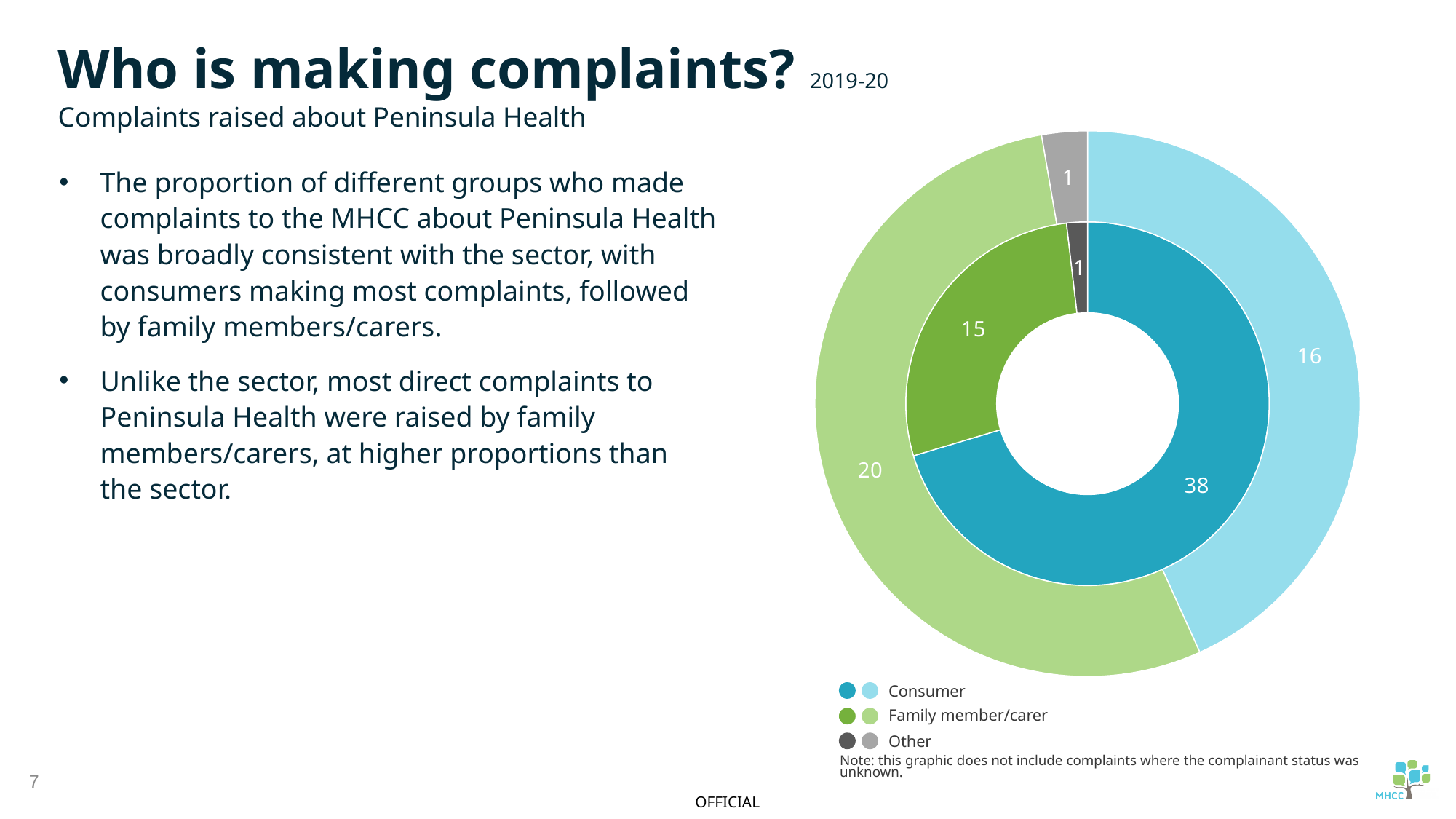
What type of chart is shown on the slide? Doughnut chart Which category has the largest value in the outer ring of the doughnut chart? Family member/carer What is the value for Family member/carer in the inner ring of the doughnut chart? 15 Which category has the largest value in the inner ring of the doughnut chart? Consumer Which category has the smallest value in the outer ring of the doughnut chart? Other What is the value for Consumer in the inner ring of the doughnut chart? 38 What is the value for Consumer in the outer ring of the doughnut chart? 16 What is the difference between the Consumer and Family member/carer values in the inner ring? 23 What is the value for Family member/carer in the outer ring of the doughnut chart? 20 How many categories does the legend list? 3 Which colour represents the Other category in the legend? Grey What is the total of all values in the outer ring of the doughnut chart? 37